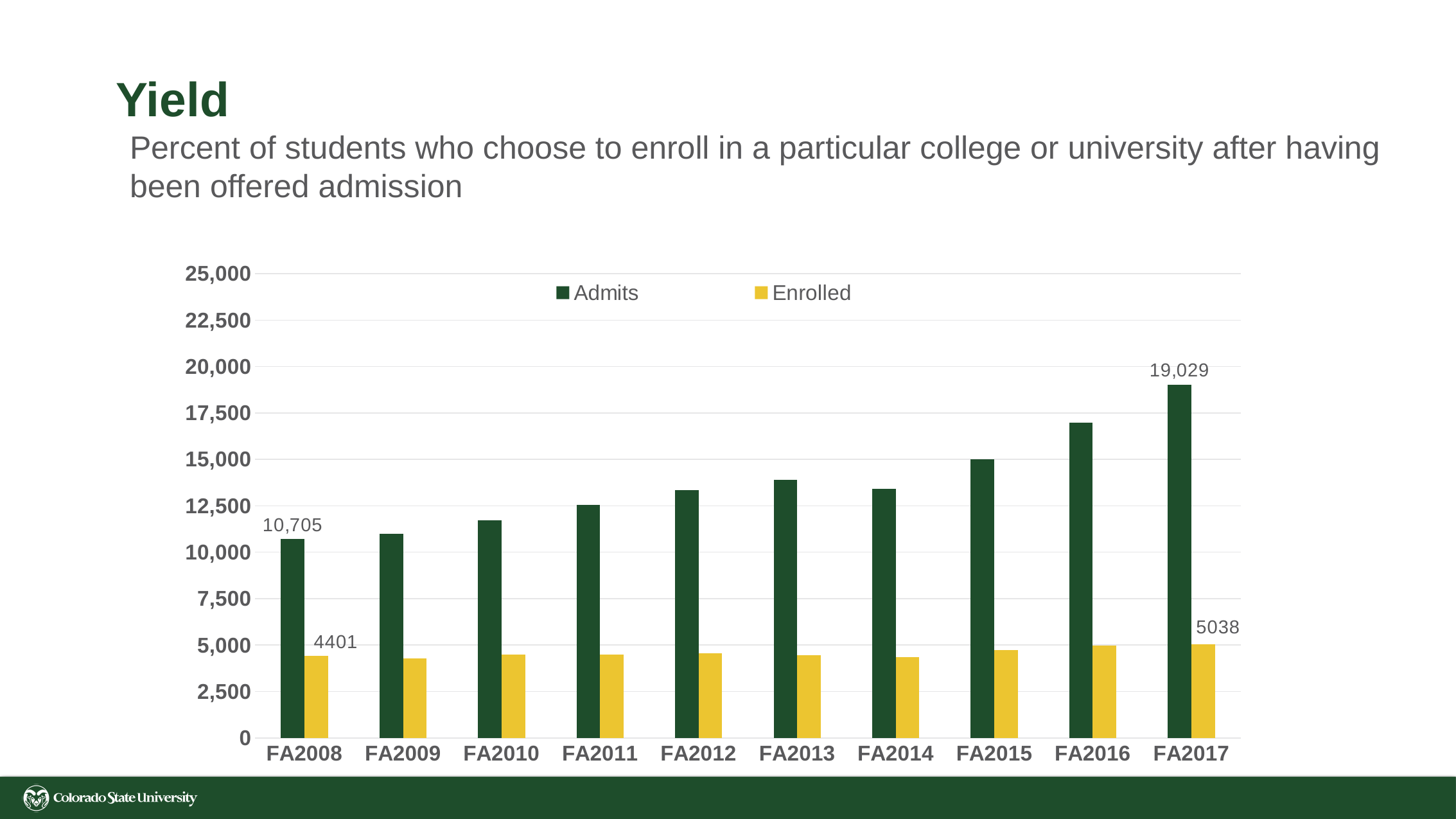
What is the Enrolled value for FA2017? 5038 Which year has the highest Admits value? FA2017 What is the difference between the Admits values for FA2017 and FA2008? 8,324 What is the Admits value for FA2017? 19,029 Is the Enrolled value for FA2012 greater or less than 5,000? less Is the Admits value for FA2015 greater or less than 12,500? greater How many years are shown on the x axis? 10 Which year has the lowest Admits value? FA2008 What is the Enrolled value for FA2008? 4401 What is the Admits value for FA2008? 10,705 How many series does the legend list? 2 What kind of chart is shown on the slide? Bar chart